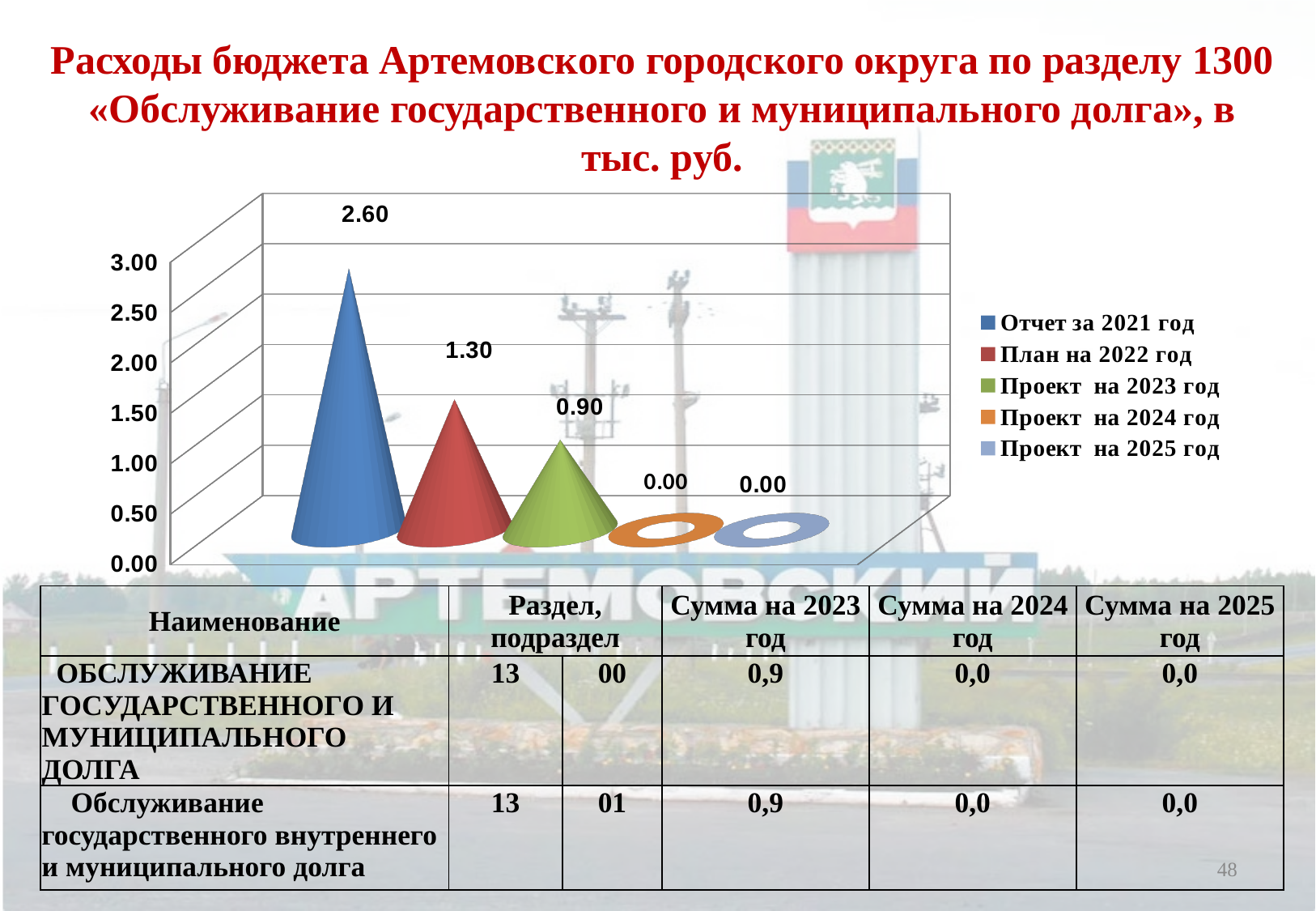
Is the value for «Отчет за 2021 год» greater or less than 2.00? greater What colour is the cone for «Отчет за 2021 год»? blue What is the value for «Отчет за 2021 год»? 2.60 What is the difference between the values for «План на 2022 год» and «Проект на 2023 год»? 0.40 What is the value for «Проект на 2024 год»? 0.00 How many series does the legend list? 5 Which series has the highest value? Отчет за 2021 год What is the value for «План на 2022 год»? 1.30 What is the difference between the values for «Отчет за 2021 год» and «План на 2022 год»? 1.30 Do the values rise or fall from the 2021 report to the 2025 project? fall Which is larger, the value for «План на 2022 год» or for «Проект на 2023 год»? План на 2022 год What is the value for «Проект на 2023 год»? 0.90